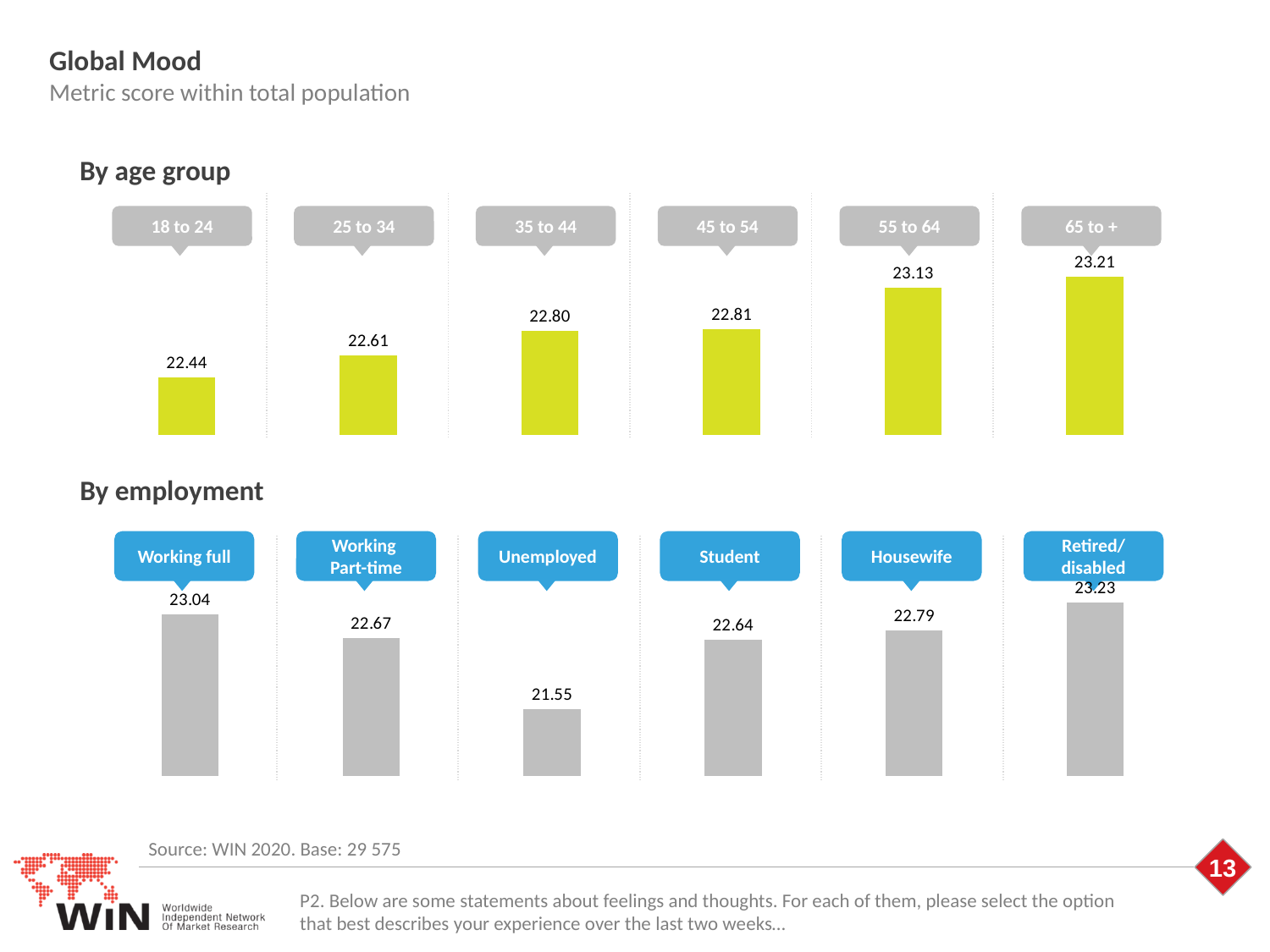
In the 'By age group' chart, which age group has the highest value? 65 to + In the 'By age group' chart, do the values rise or fall from 18 to 24 through 65 to +? rise In the 'By age group' chart, what is the difference between the values for 65 to + and 18 to 24? 0.77 In the 'By age group' chart, how many age groups are shown? 6 What kind of chart is the 'By employment' chart? bar chart In the 'By employment' chart, what is the value for Unemployed? 21.55 In the 'By employment' chart, which category has the lowest value? Unemployed In the 'By employment' chart, what is the difference between the values for Working full and Working Part-time? 0.37 In the 'By employment' chart, which is larger, the value for Working full or the value for Housewife? Working full In the 'By age group' chart, what is the value for the 18 to 24 age group? 22.44 In the 'By employment' chart, which category has the highest value? Retired/disabled In the 'By age group' chart, which age group has the lowest value? 18 to 24